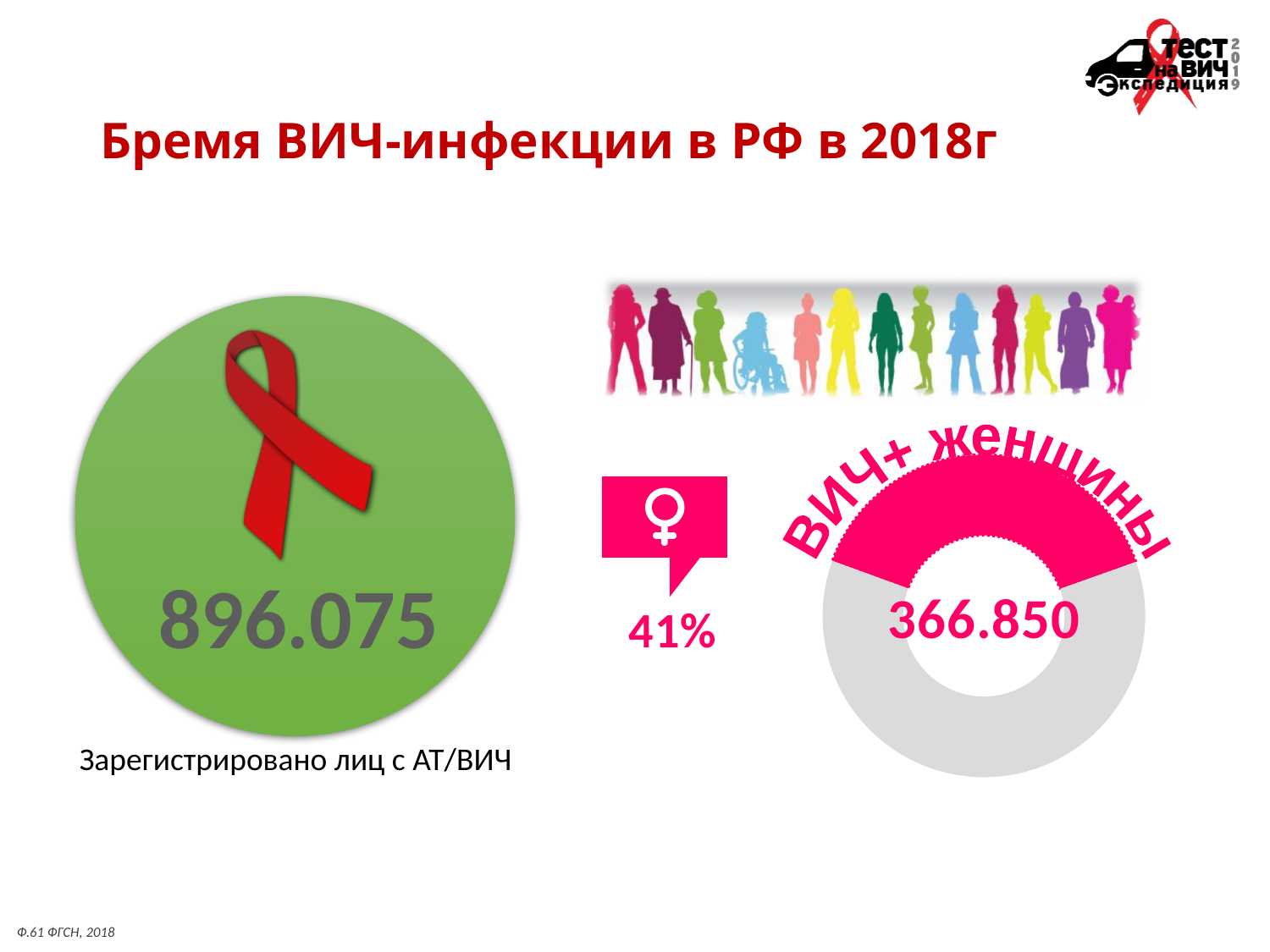
How many segments does the donut chart have? 2 What share of the donut chart does the pink segment (ВИЧ+ женщины) represent? 41% What is the title of the slide containing the donut chart? Бремя ВИЧ-инфекции в РФ в 2018г Which segment of the donut chart is larger, the pink one or the grey one? the grey one What kind of chart is shown on the right side of the slide? Donut (pie) chart What value is printed in the centre of the donut chart? 366.850 What category does the pink segment of the donut chart represent? ВИЧ+ женщины Is the pink segment of the donut chart greater or less than 50% of the whole? less What is the total number of registered persons with AT/HIV shown in the green circle on the slide? 896.075 What colour is the segment labelled ВИЧ+ женщины in the donut chart? Pink